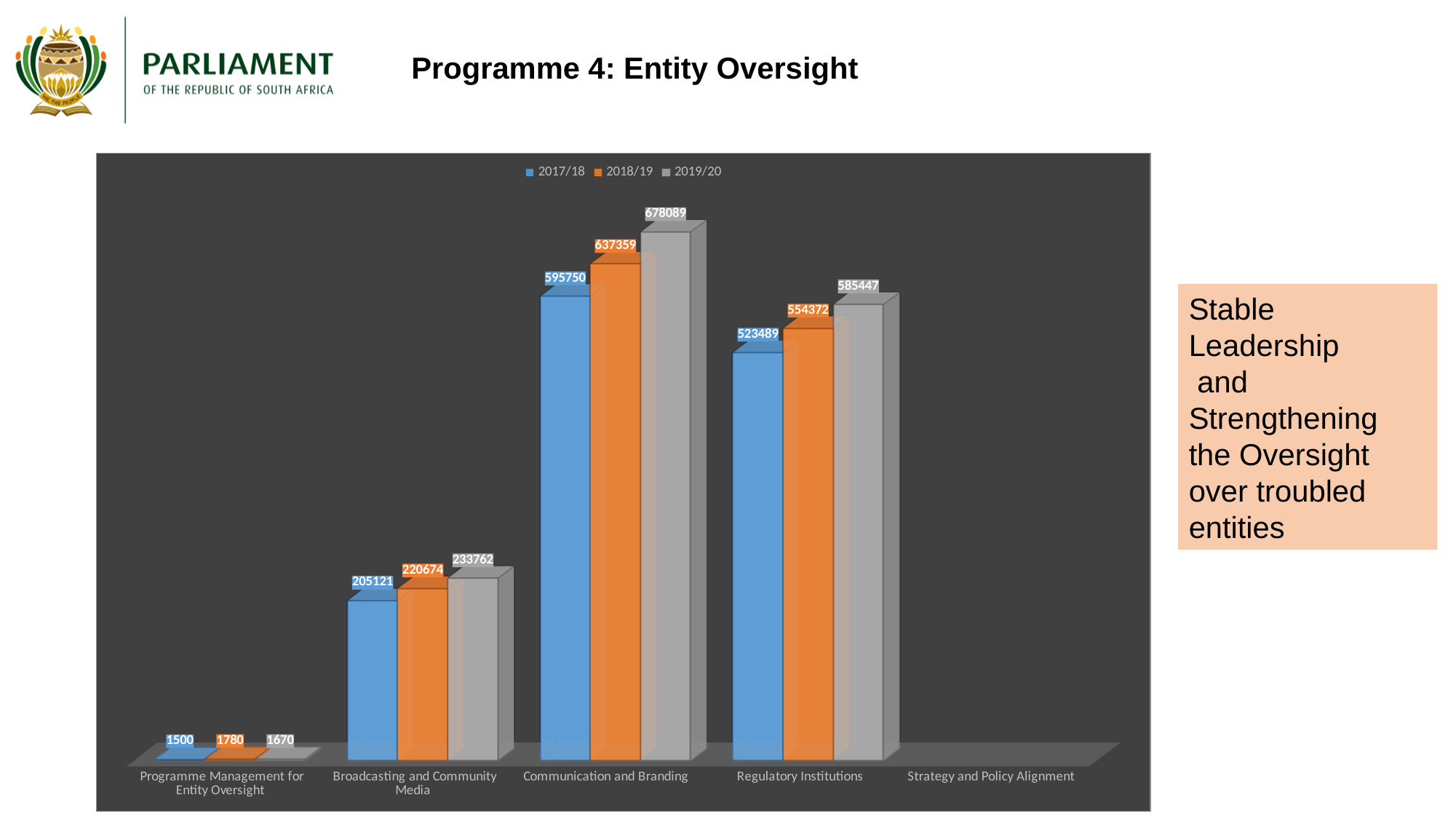
What is the value for Regulatory Institutions in 2017/18? 523489 What is the value for Broadcasting and Community Media in 2018/19? 220674 Which is larger for Regulatory Institutions: the 2018/19 value or the 2019/20 value? 2019/20 Which category has the highest value in 2018/19? Communication and Branding How many categories are labelled on the x axis? 5 What kind of chart is shown on the slide? Bar chart What is the value for Communication and Branding in 2019/20? 678089 What is the value for Programme Management for Entity Oversight in 2019/20? 1670 Do the values for Broadcasting and Community Media rise or fall from 2017/18 to 2019/20? Rise What is the difference between the 2019/20 and 2017/18 values for Communication and Branding? 82339 Among the categories with plotted bars, which has the lowest value in 2017/18? Programme Management for Entity Oversight How many series does the legend list? 3